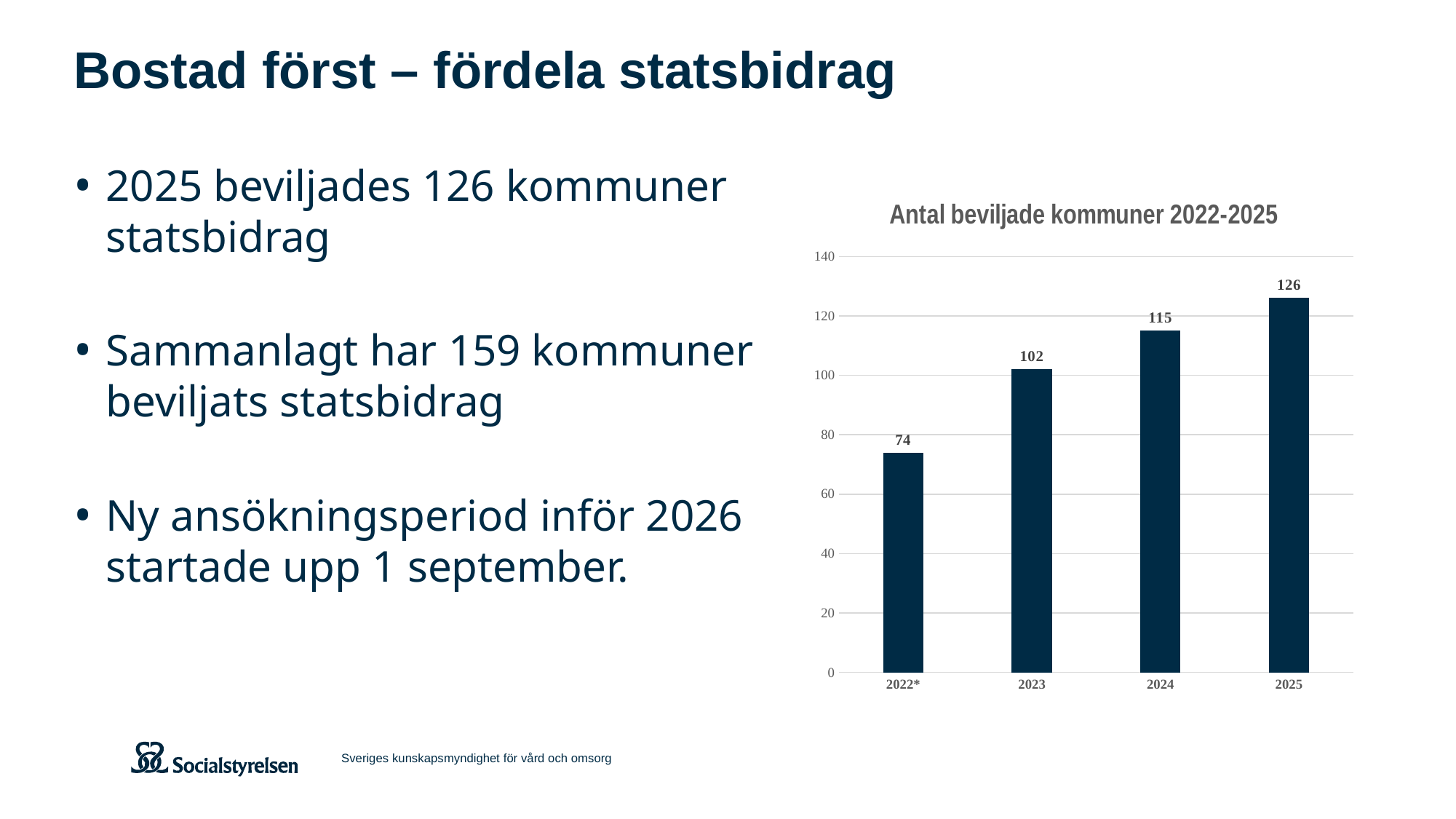
What is the value for 2022* in the chart? 74 What is the value for 2023 in the chart? 102 Is the value for 2025 greater or less than 120? greater Do the values rise or fall from 2022* to 2025? rise What is the value for 2024 in the chart? 115 Which year has the highest value in the chart? 2025 What is the difference between the values for 2024 and 2023? 13 What kind of chart is shown on the slide? bar chart What is the difference between the values for 2025 and 2022*? 52 Which year has the lowest value in the chart? 2022* Which is larger, the value for 2023 or the value for 2024? 2024 How many years are shown on the x axis of the chart? 4